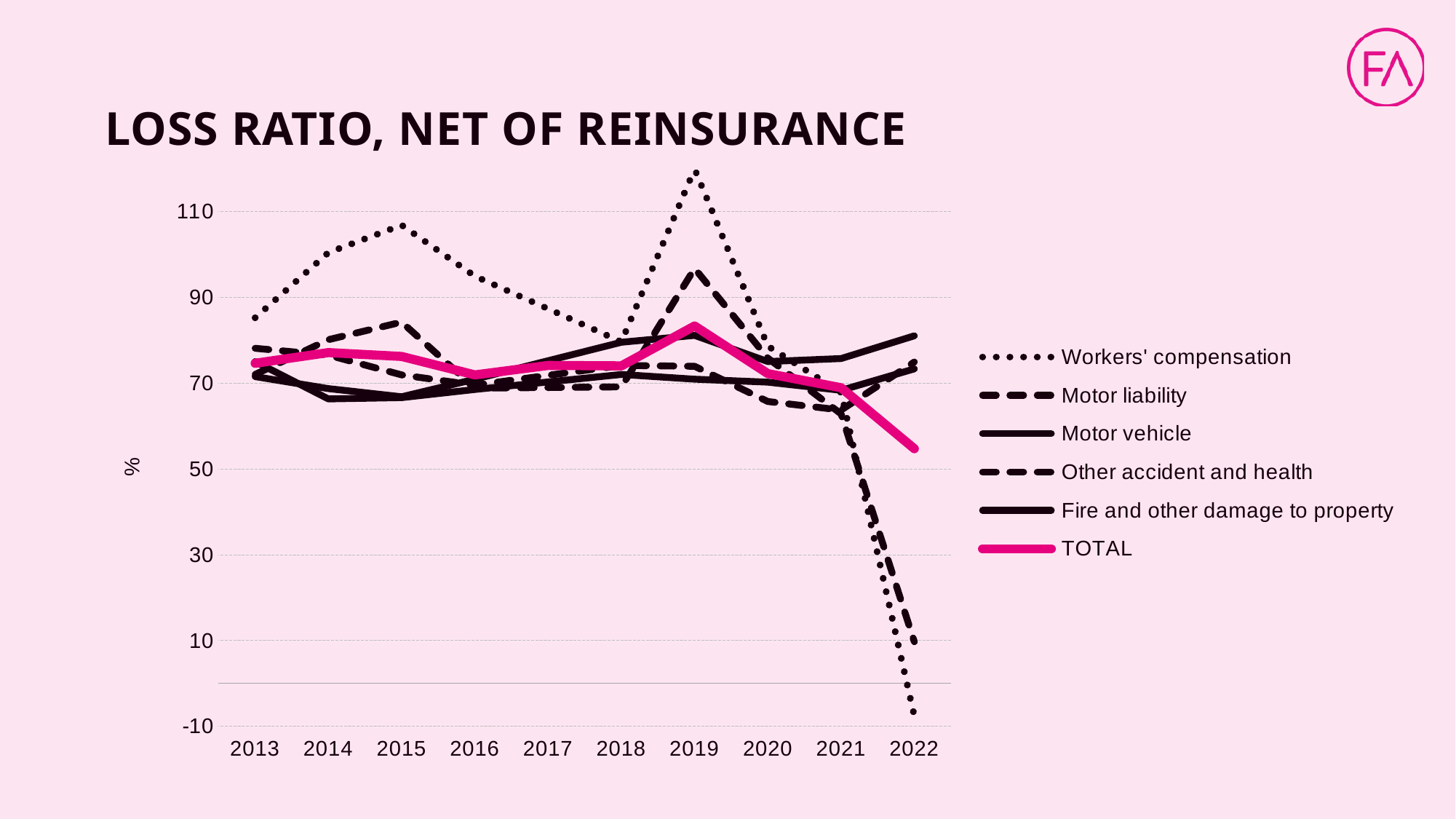
What is the title of the chart? LOSS RATIO, NET OF REINSURANCE What is the label on the y axis? % In which year is the TOTAL series at its lowest? 2022 In which year is the TOTAL series at its highest? 2019 Which series has the lowest value in 2022? Workers' compensation Does the TOTAL series rise or fall from 2019 to 2022? fall What kind of chart is shown on the slide? line chart Is the value for Workers' compensation in 2022 greater or less than 10? less How many years are shown on the x axis? 10 Which series has the highest value in 2019? Workers' compensation How many series does the legend list? 6 Is the value for Workers' compensation in 2019 greater or less than 110? greater